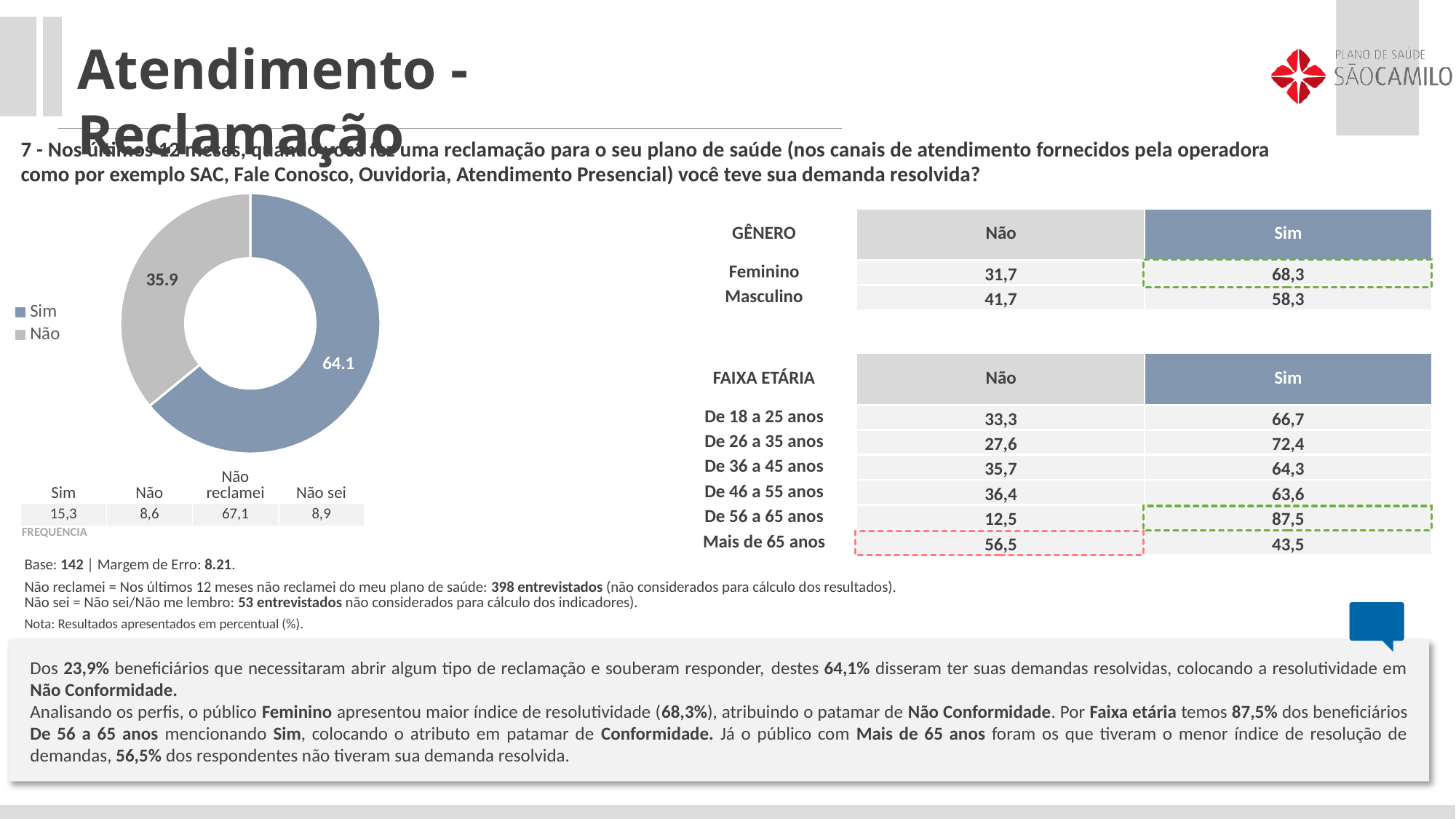
What is the difference between the Sim and Não values in the donut chart? 28.2 Which slice of the donut chart is the smallest? Não What kind of chart is shown on the left of the slide? Donut (pie) chart How many entries does the legend of the donut chart list? 2 In the donut chart, what is the value for Sim? 64.1 In the donut chart, what is the value for Não? 35.9 In the donut chart, which is larger: Sim or Não? Sim How many slices does the donut chart have? 2 What share of the donut chart does the Sim slice represent? 64.1 Which slice of the donut chart is the largest? Sim What colour is the Sim slice in the donut chart? Blue What are the two legend entries of the donut chart? Sim and Não